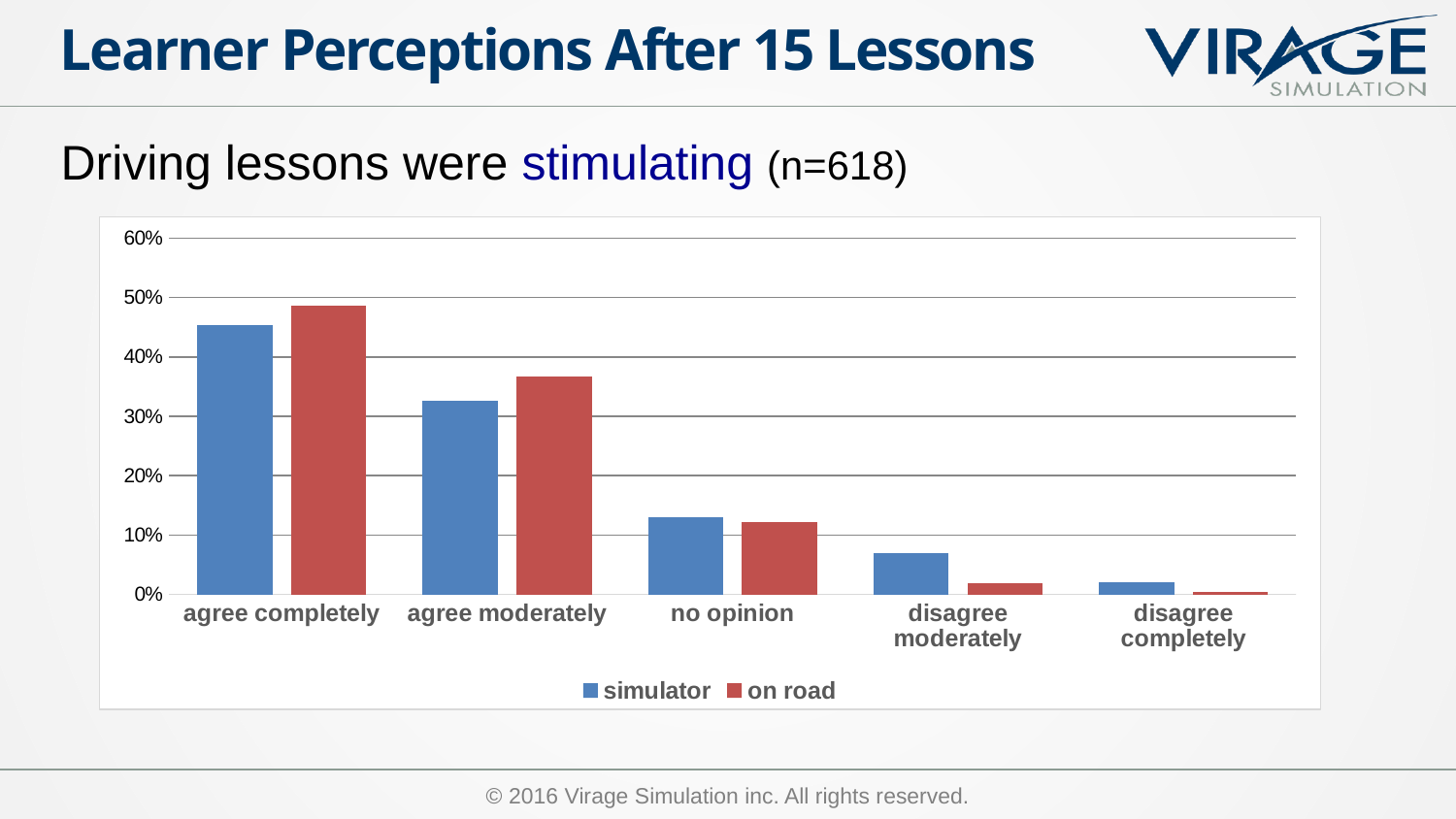
Is the on road value for 'agree moderately' greater or less than 40%? less Is the on road value for 'agree completely' greater or less than 50%? less How many series does the legend list? 2 Is the simulator value for 'agree moderately' greater or less than 30%? greater Which category has the lowest on road value? disagree completely Which series are listed in the legend? simulator and on road Which category has the highest on road value? agree completely How many response categories are shown on the x axis? 5 What kind of chart is shown on the slide? bar chart For 'disagree moderately', which is larger: the simulator value or the on road value? simulator